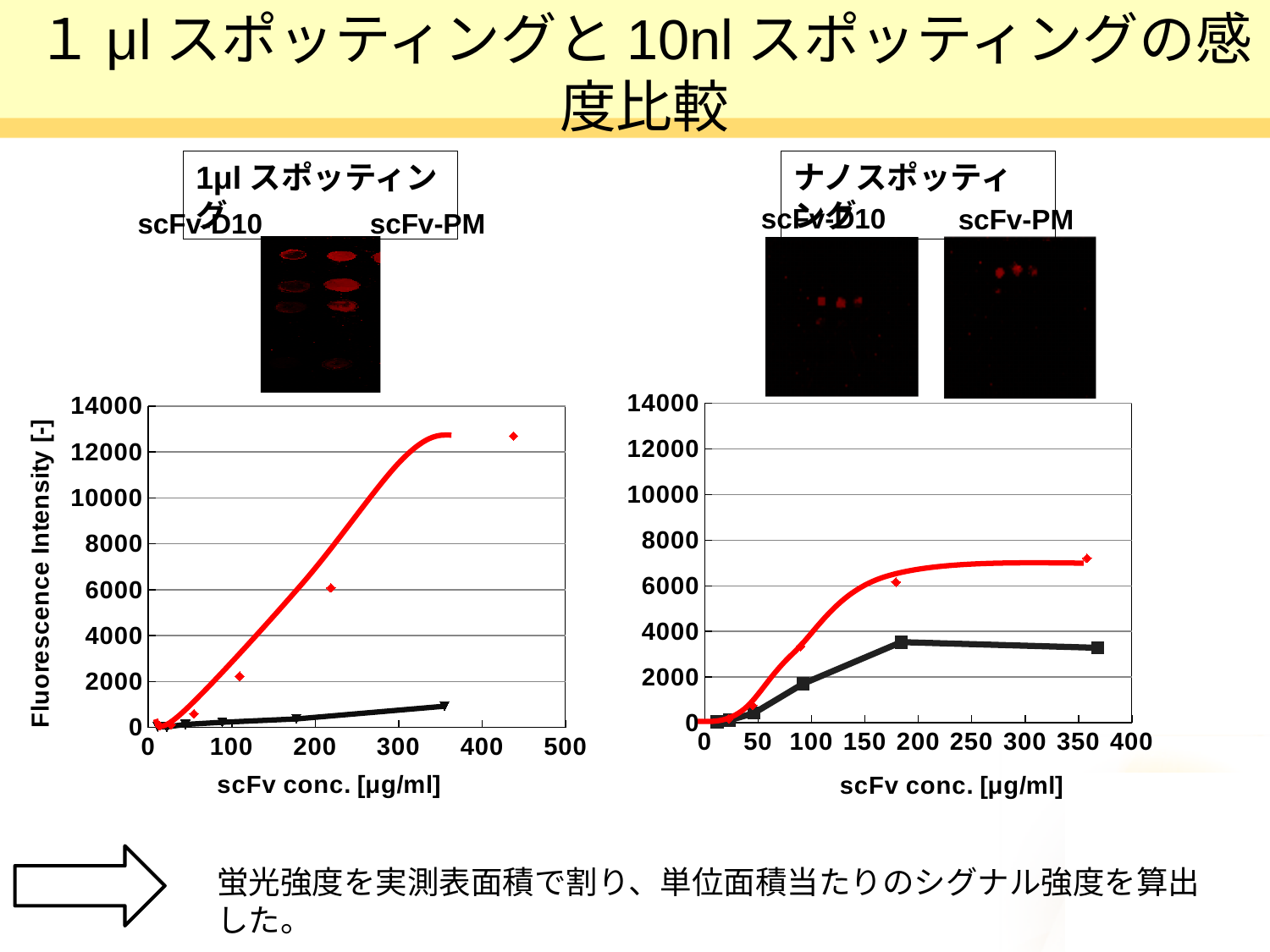
In the left chart (1µl スポッティング), is the red series value at about 440 µg/ml greater or less than 12000? greater What is the highest tick value on the y axis of the left chart (1µl スポッティング)? 14000 In the right chart (ナノスポッティング), does the red series rise or fall between 0 and 180 µg/ml? rise What kind of chart is the left chart (1µl スポッティング)? Scatter chart with fitted lines In the left chart (1µl スポッティング), which series reaches the higher fluorescence intensity, the red or the black one? red In the right chart (ナノスポッティング), which series is higher at about 360 µg/ml, the red or the black one? red In the right chart (ナノスポッティング), is the black series value at about 180 µg/ml greater or less than 4000? less In the left chart (1µl スポッティング), does the red series rise or fall as scFv concentration increases? rise In the right chart (ナノスポッティング), is the red series value at about 180 µg/ml greater or less than 4000? greater What is the x-axis title of the right chart (ナノスポッティング)? scFv conc. [µg/ml]